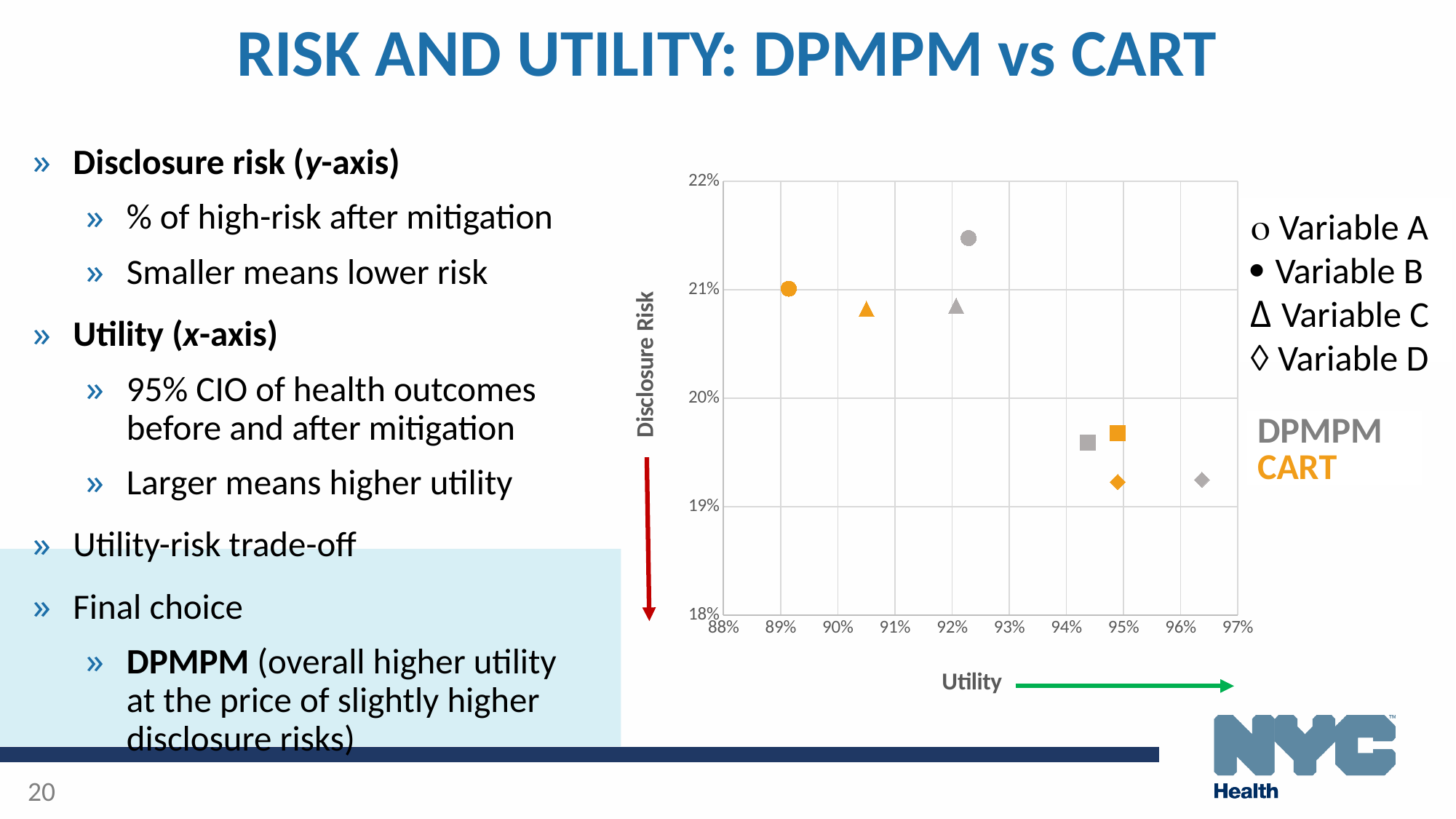
Is the utility of the gray (DPMPM) square point greater or less than 95%? less How many variables does the legend list? 4 What kind of chart is shown on the slide? scatter chart Which point has the highest disclosure risk on the chart? the gray (DPMPM) circle Which point has the lowest utility on the chart? the orange (CART) circle What is the title of the y-axis? Disclosure Risk Which has higher utility, the gray (DPMPM) diamond or the orange (CART) diamond? the gray (DPMPM) diamond How many data points are plotted on the chart? 8 Is the disclosure risk of the gray (DPMPM) triangle point greater or less than 21%? less Is the disclosure risk of the gray (DPMPM) circle point greater or less than 21%? greater Which colour represents CART on the chart? orange